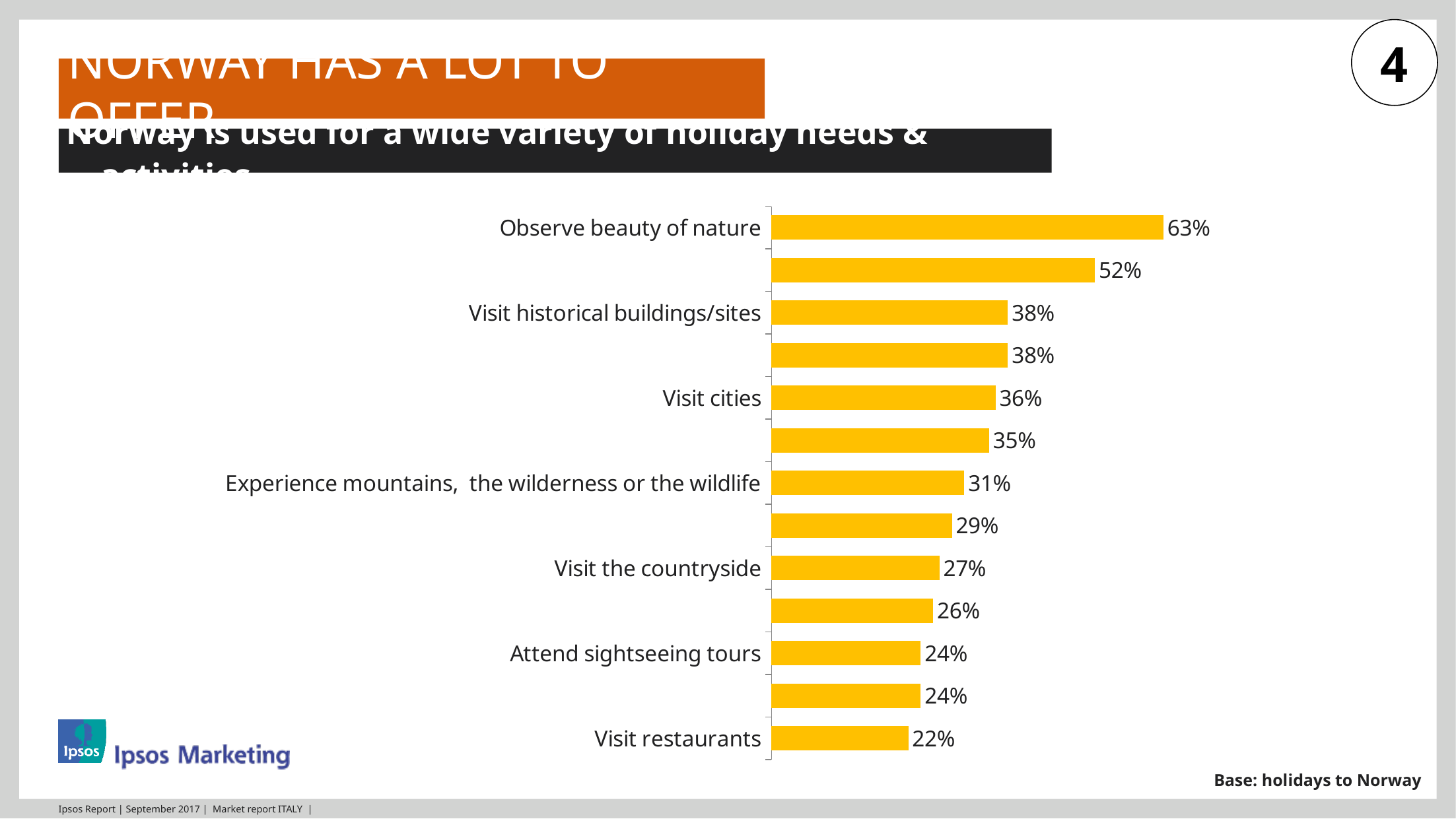
What is the difference in percentage points between "Observe beauty of nature" and "Visit restaurants"? 41 Which labelled activity has the highest percentage? Observe beauty of nature How many bars are plotted in the chart? 13 What is the value for "Visit restaurants"? 22% What percentage is shown for "Visit cities"? 36% Which labelled activity has the lowest percentage? Visit restaurants What percentage is shown for "Observe beauty of nature"? 63% What percentage is shown for "Visit the countryside"? 27% What kind of chart is shown on the slide? Bar chart What is the value for "Visit historical buildings/sites"? 38% What is the value for "Experience mountains, the wilderness or the wildlife"? 31% Which is larger: the value for "Visit cities" or for "Visit the countryside"? Visit cities